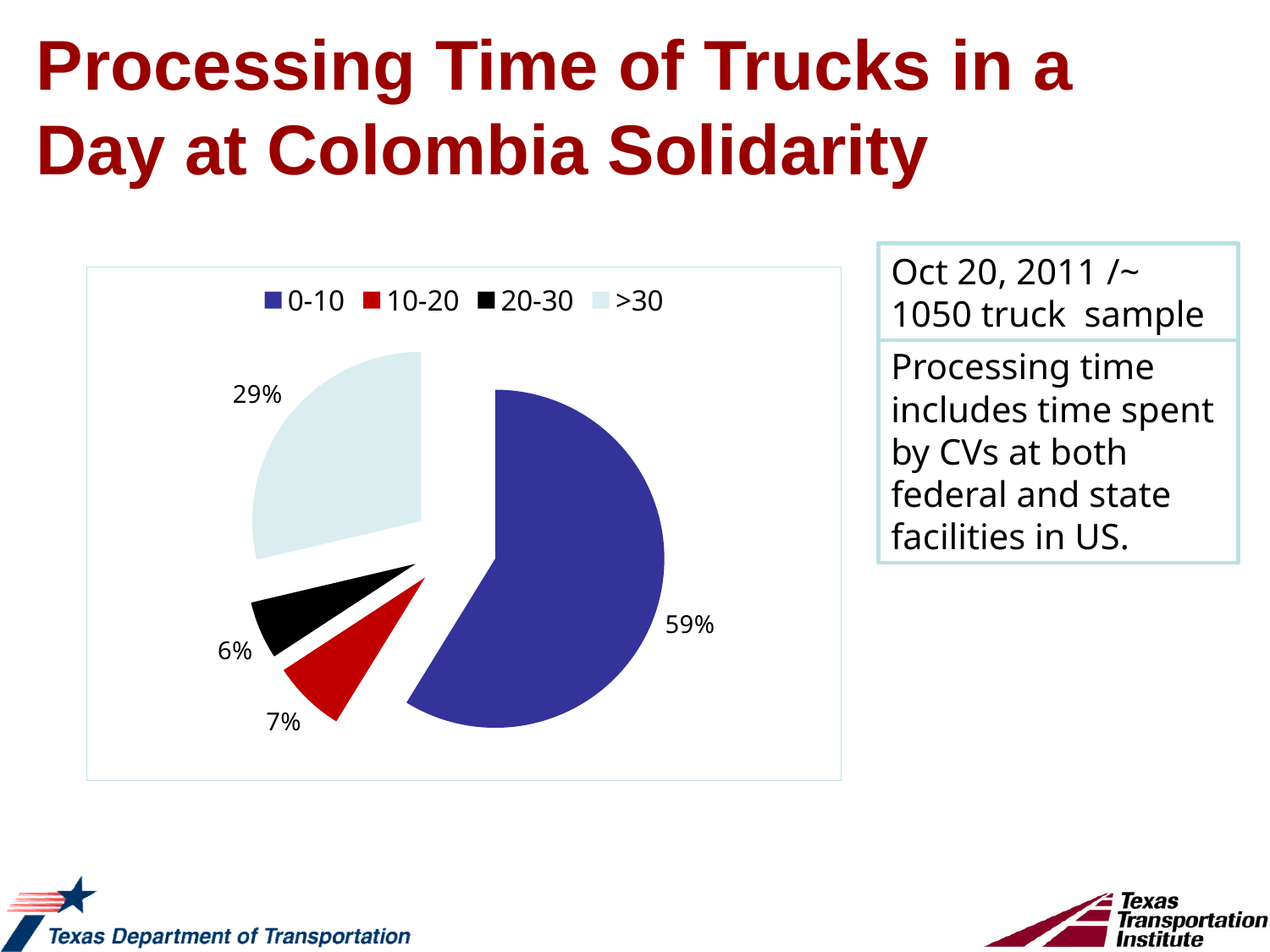
How many categories does the pie chart show? 4 Which slice is larger, 10-20 or >30? >30 Which processing time category has the smallest share of the pie? 20-30 What is the difference in percentage points between the 0-10 slice and the >30 slice? 30 What share of trucks had a processing time of 10-20? 7% What kind of chart is shown on the slide? pie chart What share of trucks had a processing time of 20-30? 6% What colour is the 0-10 slice of the pie? blue What share of trucks had a processing time of >30? 29% How many entries does the legend list? 4 Which processing time category has the largest share of the pie? 0-10